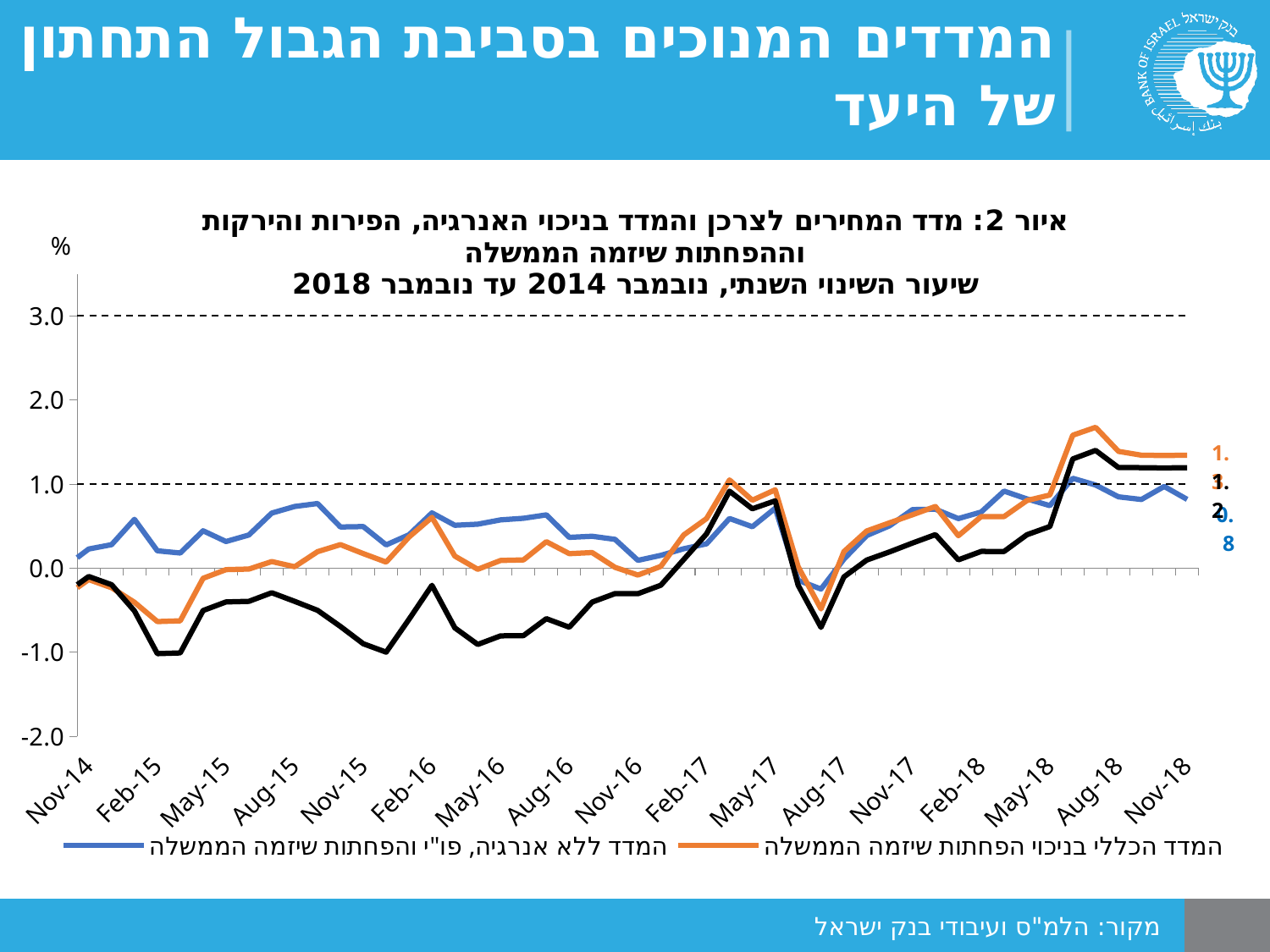
How many series does the chart's legend list? 2 Is the value of the orange line (המדד הכללי בניכוי הפחתות שיזמה הממשלה) at Feb-15 greater or less than 0.0? less Is the value of the blue line (המדד ללא אנרגיה, פו"י והפחתות שיזמה הממשלה) at Nov-18 greater or less than 1.0? less Is the value of the orange line (המדד הכללי בניכוי הפחתות שיזמה הממשלה) at Nov-18 greater or less than 1.0? greater Does the orange line (המדד הכללי בניכוי הפחתות שיזמה הממשלה) overall rise or fall between Nov-16 and Aug-18? rise At Nov-18, which line is higher: the orange line (המדד הכללי בניכוי הפחתות שיזמה הממשלה) or the blue line (המדד ללא אנרגיה, פו"י והפחתות שיזמה הממשלה)? the orange line What kind of chart is shown on the slide? line chart What unit is shown at the top of the y axis? % How many month labels are shown along the x axis? 17 Which series is drawn in orange according to the legend? המדד הכללי בניכוי הפחתות שיזמה הממשלה